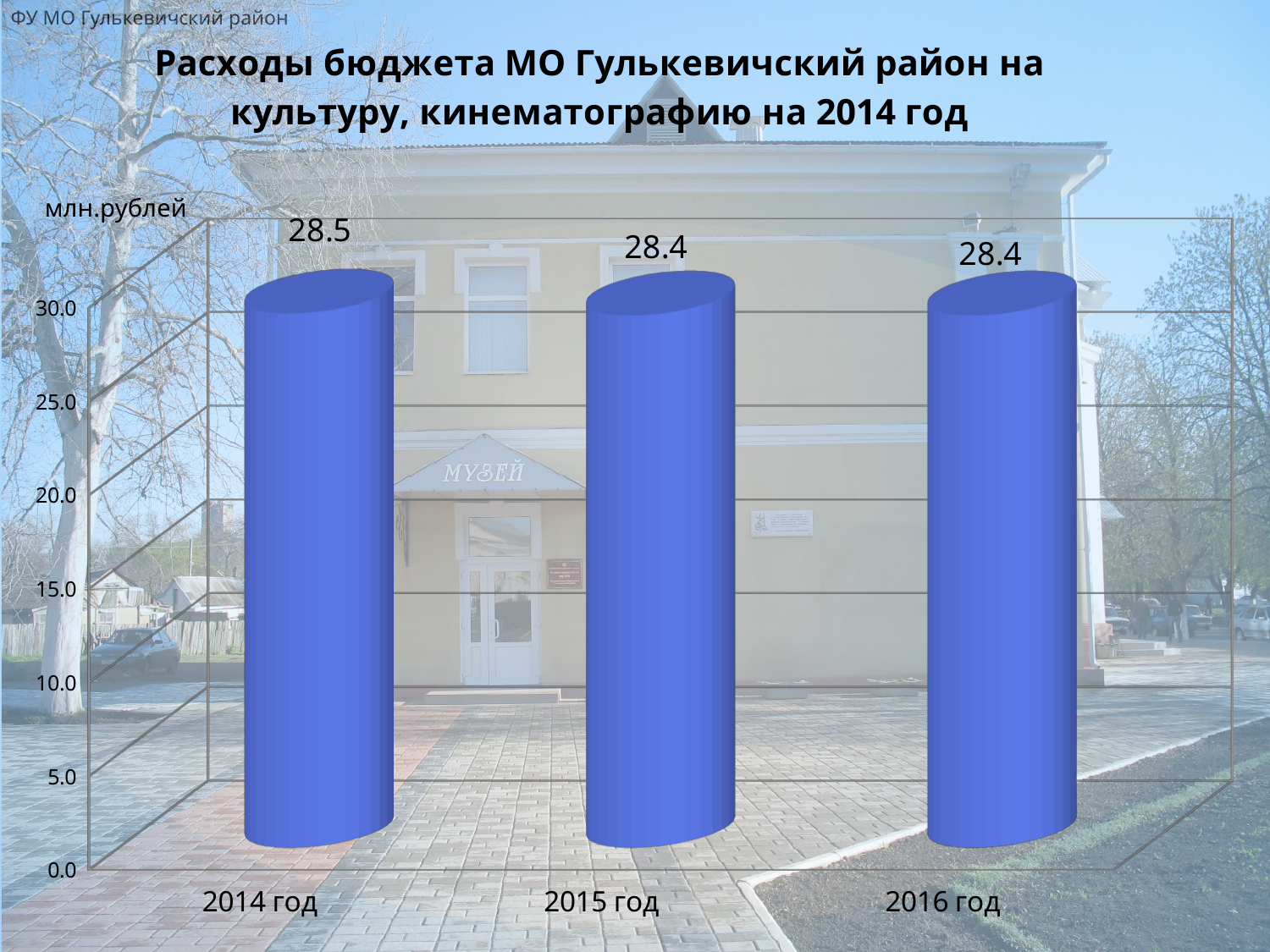
Is the value for 2015 год greater or less than 25.0? greater What kind of chart is shown on the slide? bar chart Which is larger, the value for 2014 год or the value for 2016 год? 2014 год Do the values rise or fall from 2014 год to 2015 год? fall What is the value for 2016 год? 28.4 What is the difference between the values for 2014 год and 2015 год? 0.1 Which year has the highest value? 2014 год How many years are shown on the chart? 3 Is the value for 2016 год greater or less than 30.0? less What unit is shown on the vertical axis of the chart? млн.рублей What is the value for 2014 год? 28.5 What is the value for 2015 год? 28.4